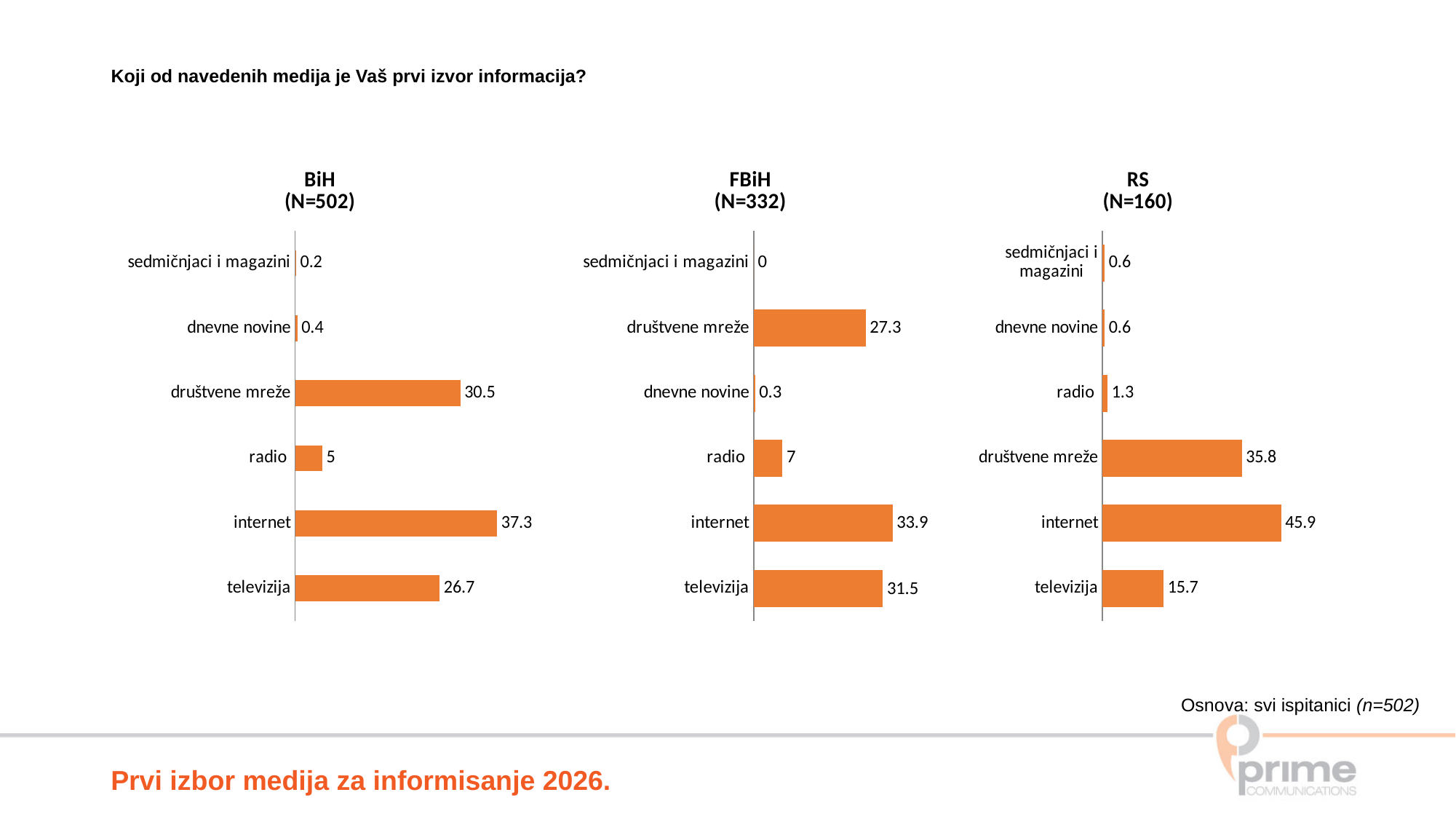
In the RS (N=160) chart, what is the difference between the values for internet and društvene mreže? 10.1 What kind of chart is the FBiH (N=332) chart? bar chart In the FBiH (N=332) chart, which category has the lowest value? sedmičnjaci i magazini In the FBiH (N=332) chart, what is the value for društvene mreže? 27.3 In the BiH (N=502) chart, what is the value for radio? 5 In the RS (N=160) chart, what is the value for televizija? 15.7 In the BiH (N=502) chart, what is the difference between the values for internet and televizija? 10.6 In the RS (N=160) chart, which category has the highest value? internet How many categories are shown in the BiH (N=502) chart? 6 How many charts are shown on the slide? 3 In the BiH (N=502) chart, what is the value for internet? 37.3 In the FBiH (N=332) chart, which is larger, the value for televizija or the value for društvene mreže? televizija